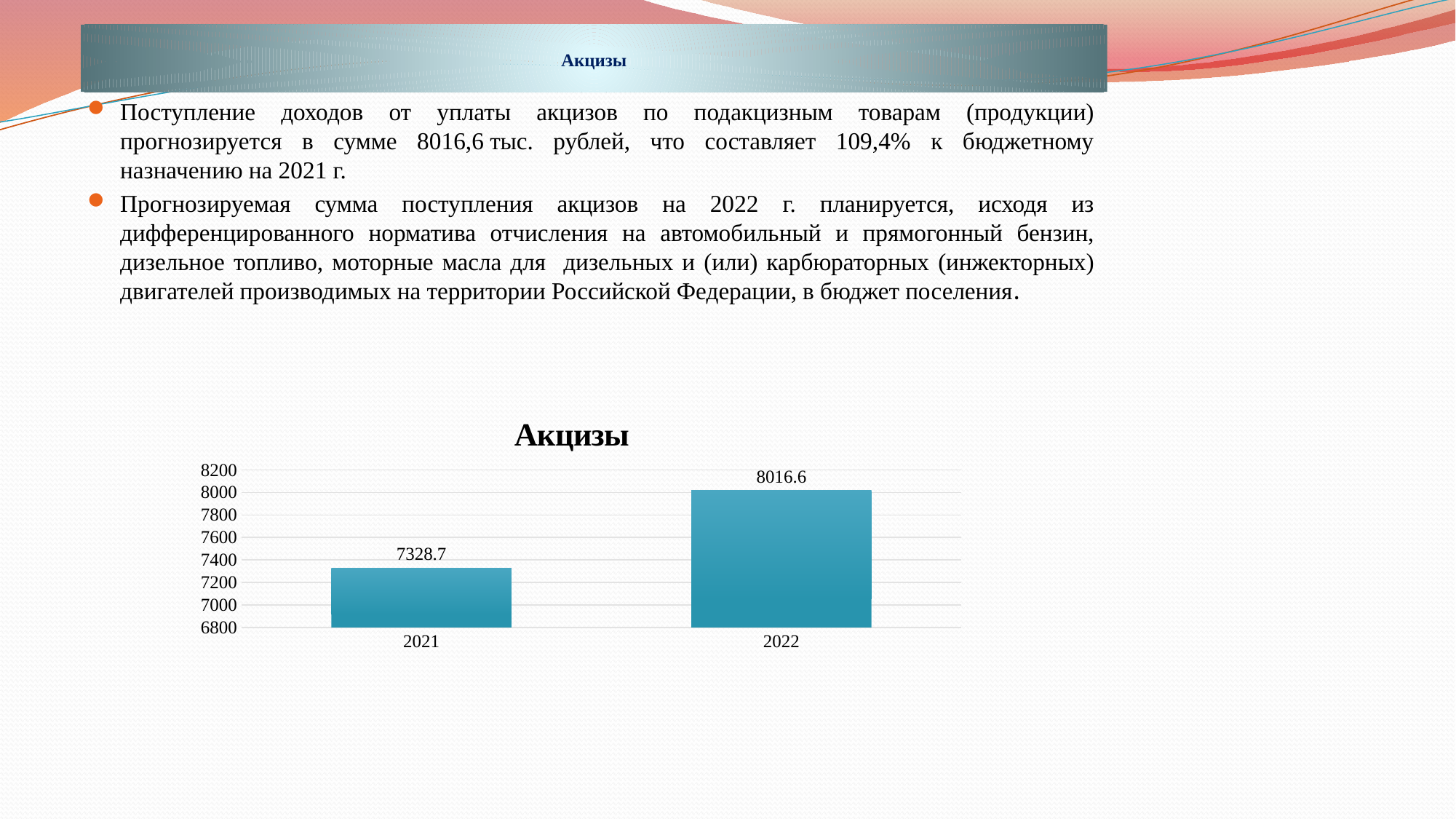
Which year has the lowest value in the chart? 2021 What is the value for 2021 in the chart? 7328.7 What kind of chart is shown on the slide? bar chart Is the value for 2021 greater or less than 7400? less What is the difference between the values for 2022 and 2021? 687.9 Which year has the highest value in the chart? 2022 How many categories are shown on the x axis of the chart? 2 Which is larger, the value for 2021 or the value for 2022? 2022 Is the value for 2022 greater or less than 8000? greater What is the title of the chart? Акцизы Do the values rise or fall from 2021 to 2022? rise What is the value for 2022 in the chart? 8016.6